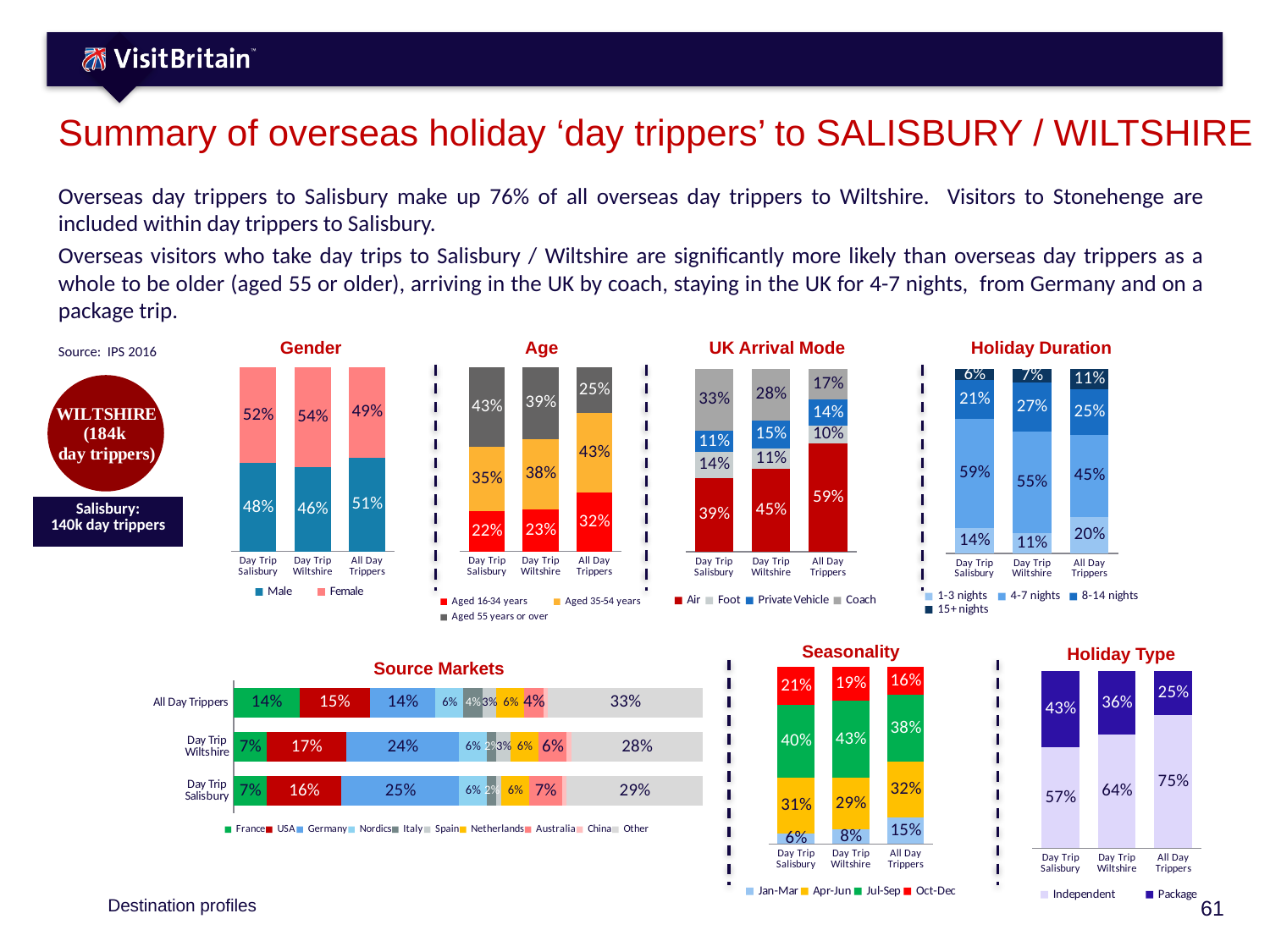
In the Holiday Duration chart, which group has the lowest share staying 1-3 nights? Day Trip Wiltshire In the UK Arrival Mode chart, what percentage of Day Trip Salisbury visitors arrive by Coach? 33% In the UK Arrival Mode chart, which group has the highest share arriving by Air? All Day Trippers How many series does the legend of the Seasonality chart list? 4 In the Source Markets chart, is the USA share larger for Day Trip Wiltshire or for All Day Trippers? Day Trip Wiltshire In the Source Markets chart, what percentage of Day Trip Salisbury visitors are from Germany? 25% In the Holiday Duration chart, what is the difference between the 4-7 nights share for Day Trip Salisbury and for All Day Trippers? 14 percentage points In the Gender chart, what percentage of Day Trip Wiltshire visitors are Male? 46% In the Seasonality chart, what percentage of Day Trip Wiltshire visits occur in Jul-Sep? 43% What kind of chart is the Source Markets chart? Stacked bar chart In the Holiday Type chart, what percentage of Day Trip Salisbury visitors are on a Package trip? 43% In the Age chart, what percentage of Day Trip Salisbury visitors are Aged 55 years or over? 43%